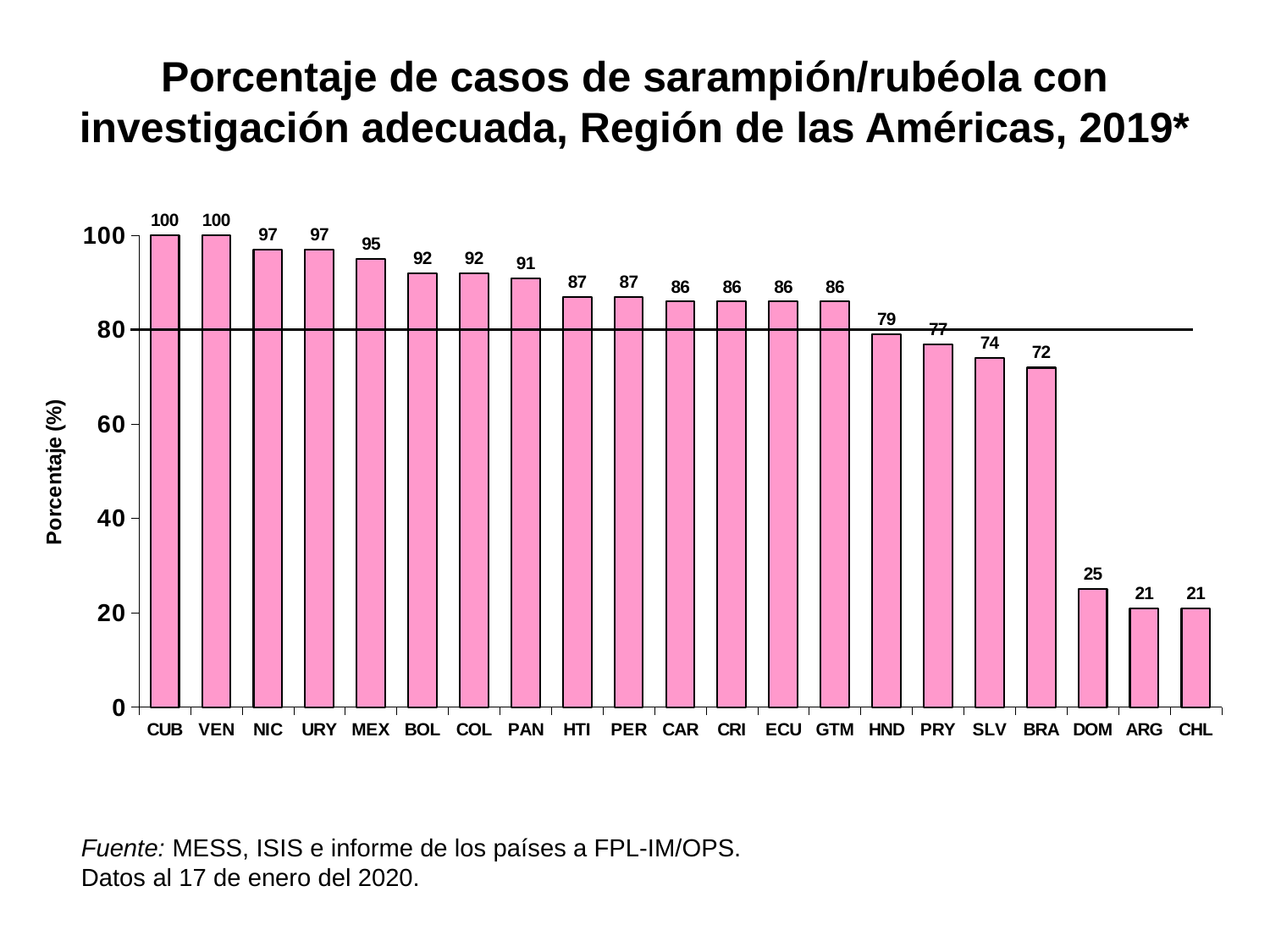
What is the value for DOM? 25 Is the value for SLV greater or less than 80? less What is the value for MEX? 95 What is the value for HND? 79 What is the difference between the values for BRA and DOM? 47 What is the label of the y axis? Porcentaje (%) Which is larger, the value for PAN or the value for PRY? PAN How many countries are shown on the x axis? 21 Do the values rise or fall from left to right along the x axis? fall Which countries have the lowest value? ARG and CHL Which countries have the highest value? CUB and VEN What kind of chart is this? bar chart